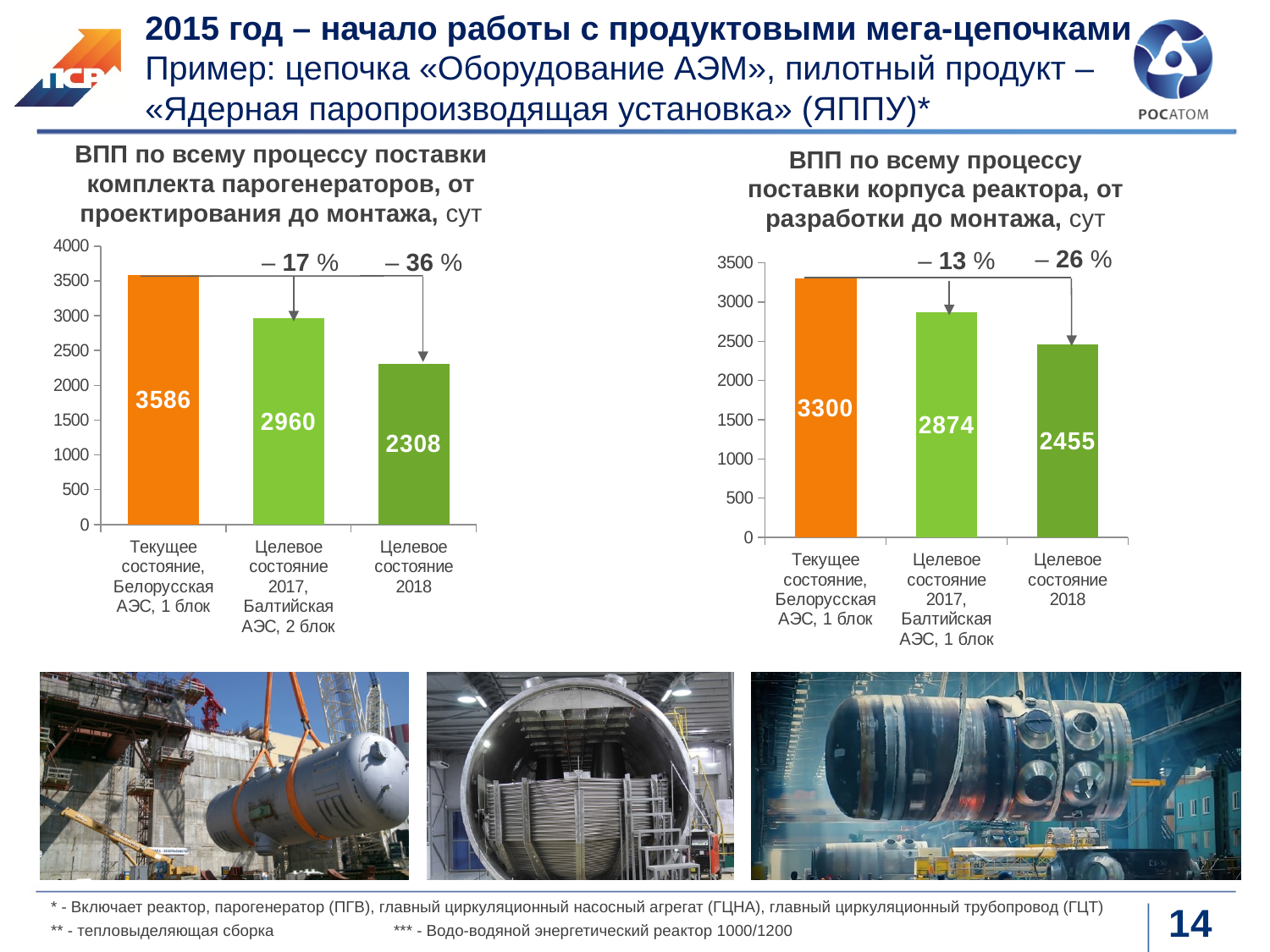
How many bars are shown in the right chart (корпус реактора)? 3 In the right chart (корпус реактора), what is the difference between the 2017 target (2874) and the 2018 target (2455)? 419 In the right chart (ВПП по всему процессу поставки корпуса реактора), what is the value for «Целевое состояние 2017, Балтийская АЭС, 1 блок»? 2874 What type of chart is the left chart (комплект парогенераторов)? Bar chart In the right chart (корпус реактора), which category has the highest value? Текущее состояние, Белорусская АЭС, 1 блок In the left chart (комплект парогенераторов), which category has the lowest value? Целевое состояние 2018 In the left chart (ВПП по всему процессу поставки комплекта парогенераторов), what is the value for «Текущее состояние, Белорусская АЭС, 1 блок»? 3586 Which is larger: the 2018 target in the left chart (комплект парогенераторов) or the 2018 target in the right chart (корпус реактора)? The right chart (корпус реактора), 2455 In the left chart (комплект парогенераторов), what percentage reduction is annotated between the current state and the 2018 target? – 36 % In the left chart (комплект парогенераторов), what is the difference between the current state (3586) and the 2017 target (2960)? 626 In the left chart (комплект парогенераторов), what is the value for «Целевое состояние 2018»? 2308 In the right chart (корпус реактора), what is the value for «Текущее состояние, Белорусская АЭС, 1 блок»? 3300